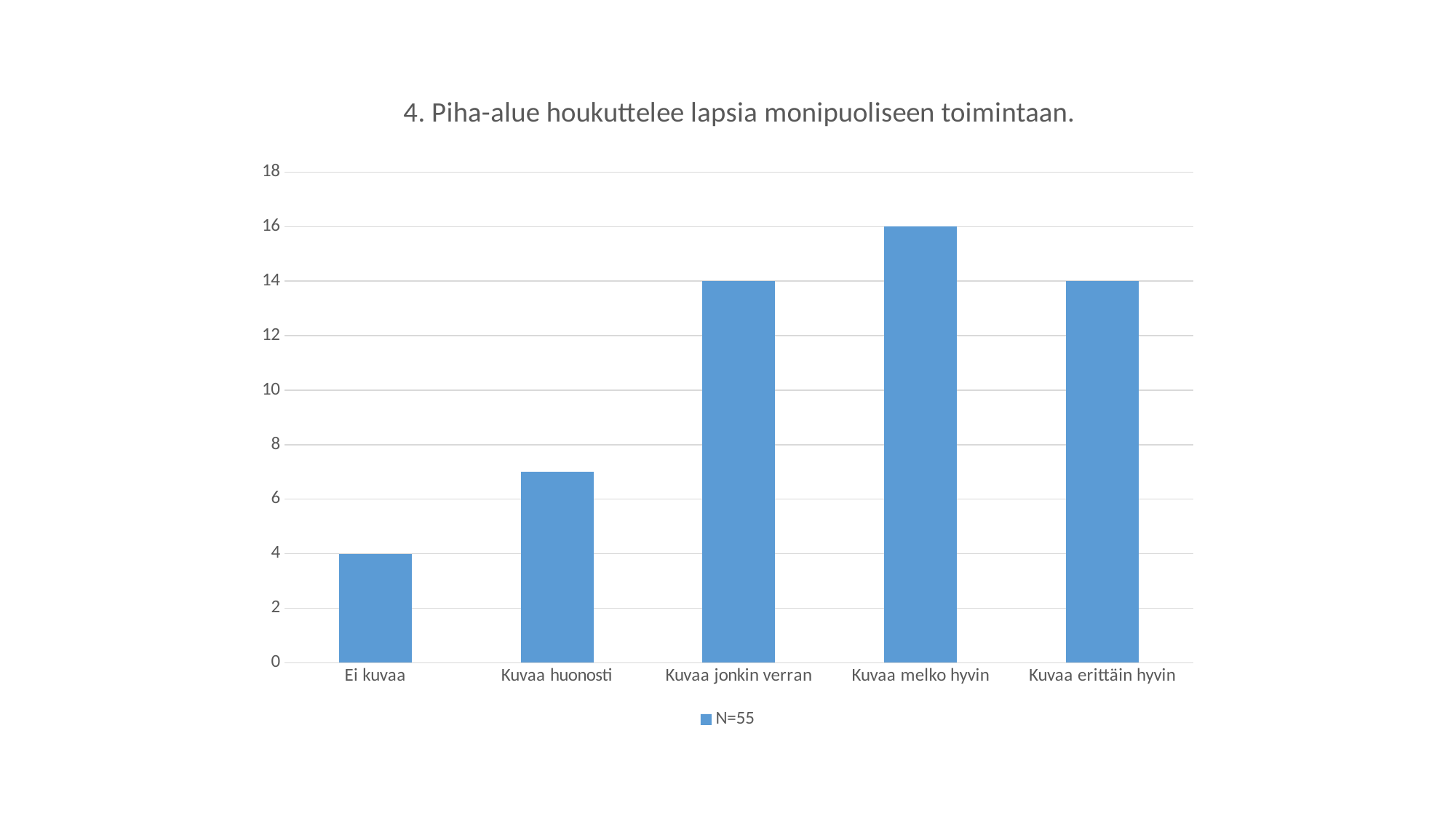
Which is larger, the value for Kuvaa huonosti or the value for Kuvaa melko hyvin? Kuvaa melko hyvin Which category has the highest value? Kuvaa melko hyvin How many categories are shown on the x axis? 5 Is the value for Kuvaa huonosti greater or less than 6? greater What kind of chart is shown on the slide? bar chart What is the value for Kuvaa melko hyvin? 16 What is the value for Kuvaa erittäin hyvin? 14 What is the legend entry shown below the chart? N=55 What is the difference between the values for Kuvaa melko hyvin and Ei kuvaa? 12 What is the value for Ei kuvaa? 4 What is the value for Kuvaa jonkin verran? 14 Which category has the lowest value? Ei kuvaa